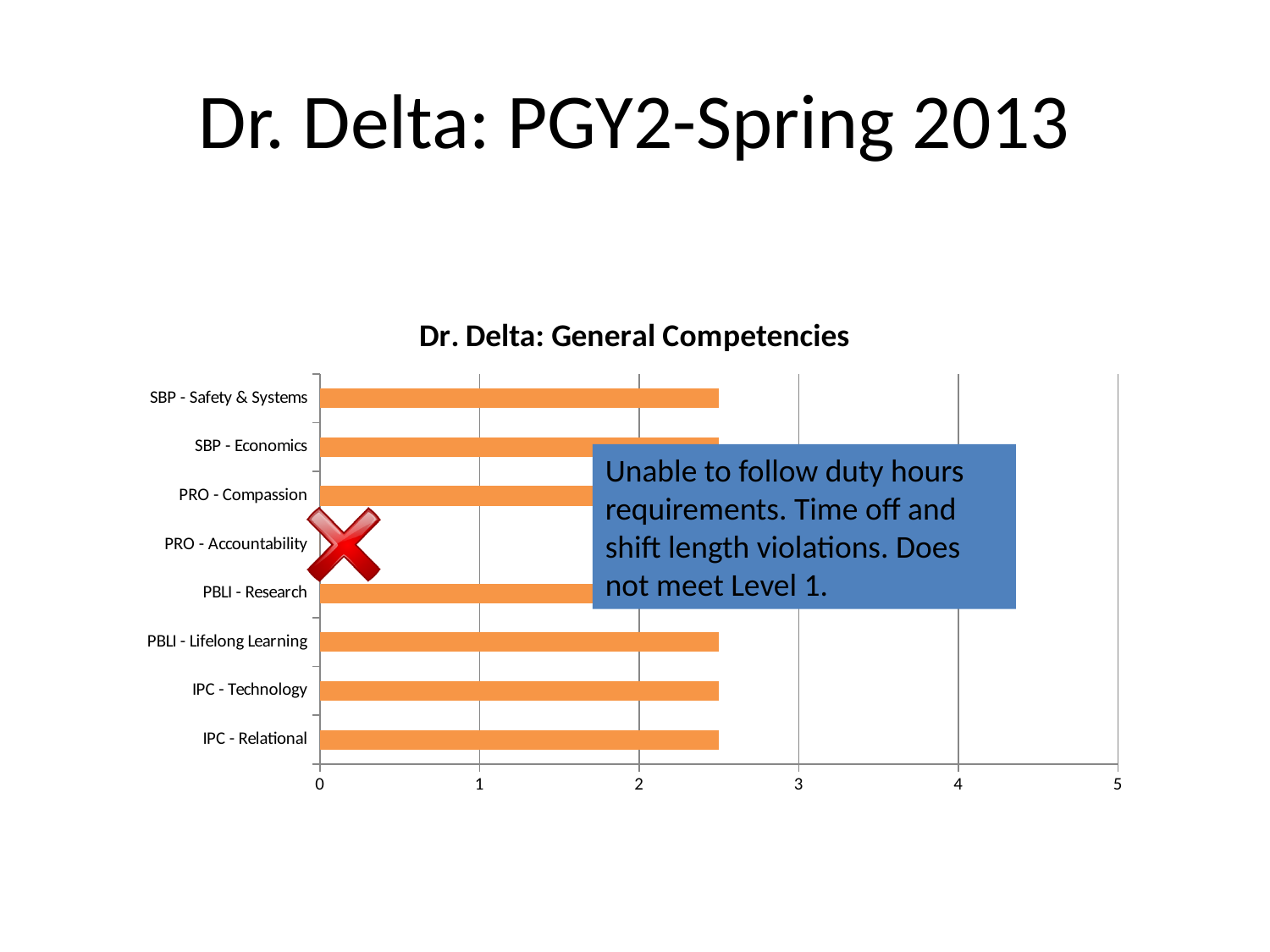
Is the value for PBLI - Lifelong Learning greater or less than 2? greater Which category has the lowest value in the chart? PRO - Accountability What kind of chart is shown on the slide? bar chart Is the value for IPC - Relational greater or less than 3? less Is the value for PRO - Accountability greater or less than 1? less How many categories are plotted in the chart? 8 Which is larger, the value for PRO - Compassion or the value for PRO - Accountability? PRO - Compassion What is the maximum value shown on the horizontal axis of the chart? 5 What is the title of the chart? Dr. Delta: General Competencies